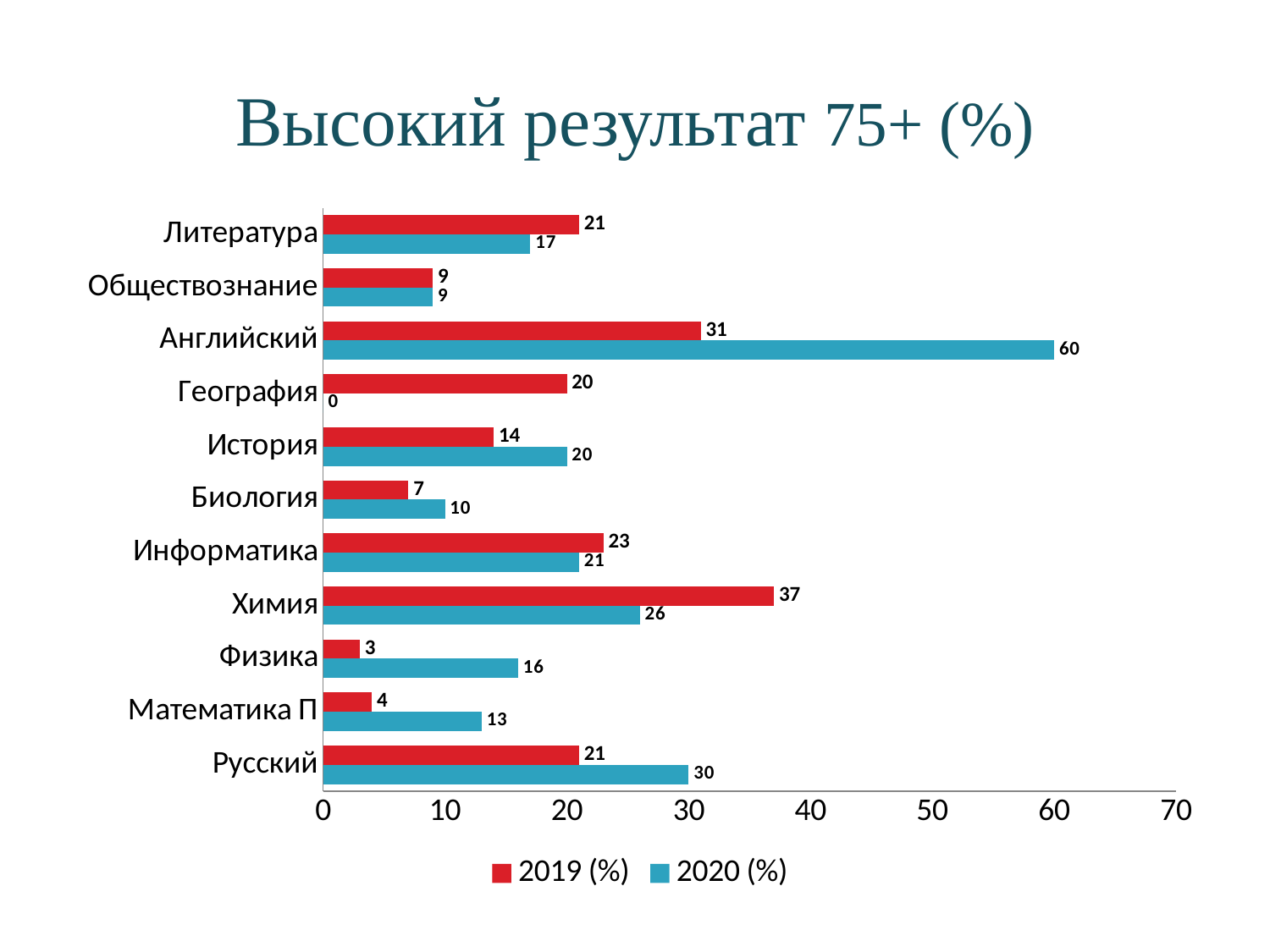
How many series does the legend list? 2 What is the 2020 (%) value for Английский? 60 What colour represents the 2020 (%) series? Blue What is the title of the chart? Высокий результат 75+ (%) What is the 2019 (%) value for Химия? 37 Which is larger for Русский: the 2019 (%) value or the 2020 (%) value? 2020 (%) How many subjects are shown on the chart? 11 What is the 2020 (%) value for География? 0 What kind of chart is shown on the slide? Bar chart What is the difference between the 2020 (%) and 2019 (%) values for Английский? 29 Which subject has the highest 2019 (%) value? Химия Which subject has the lowest 2019 (%) value? Физика